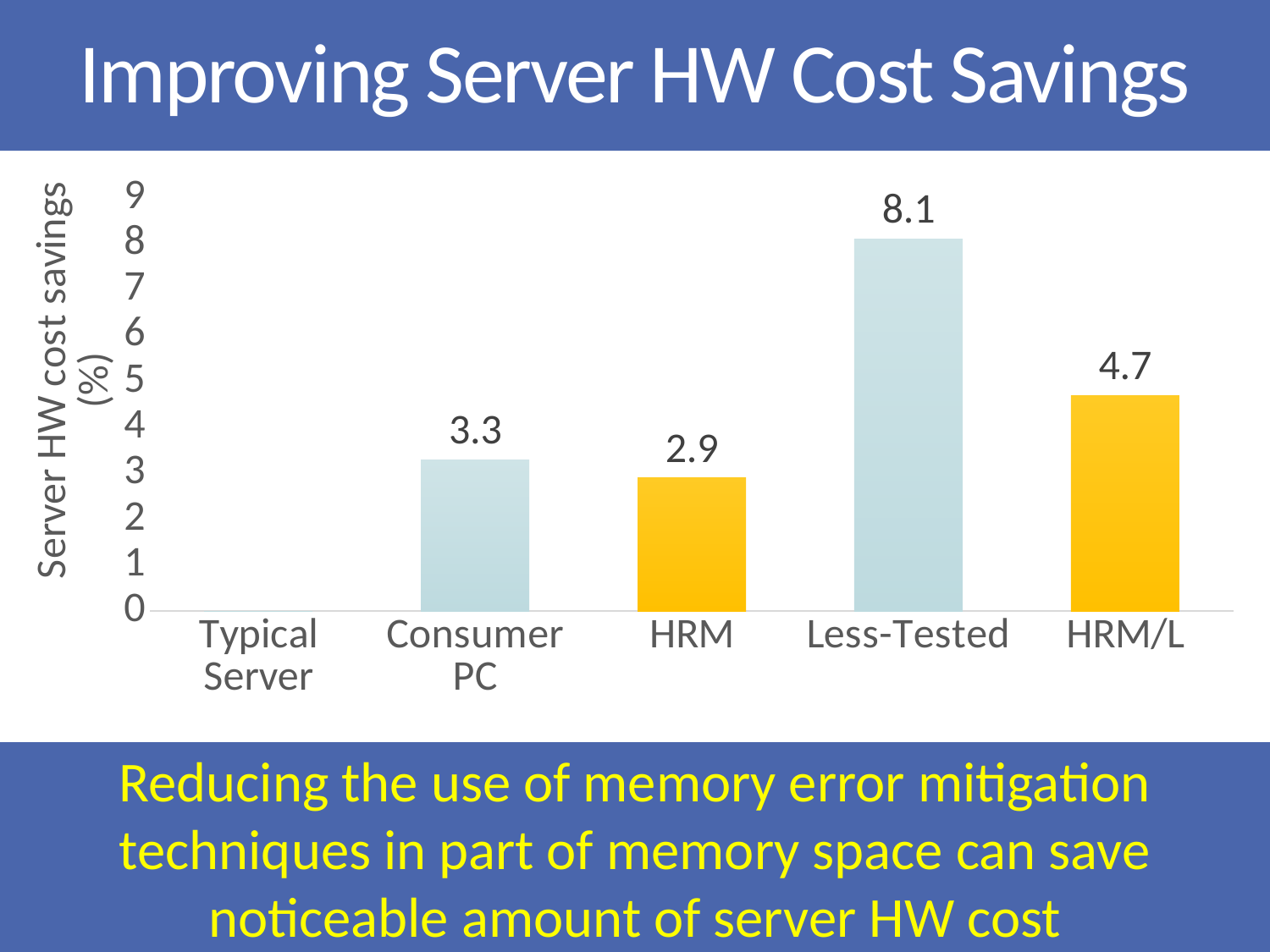
What is the server HW cost savings value for HRM? 2.9 Which category has the highest server HW cost savings? Less-Tested What kind of chart is shown on the slide? bar chart How many categories are shown on the x axis of the chart? 5 Which has a larger server HW cost savings value, Consumer PC or HRM? Consumer PC What is the difference in server HW cost savings between Less-Tested and HRM/L? 3.4 What is the server HW cost savings value for HRM/L? 4.7 What is the server HW cost savings value for Consumer PC? 3.3 What is the label of the y axis of the chart? Server HW cost savings (%) What is the server HW cost savings value for Less-Tested? 8.1 Which category has the lowest server HW cost savings? Typical Server Is the value for HRM/L greater or less than 4? greater